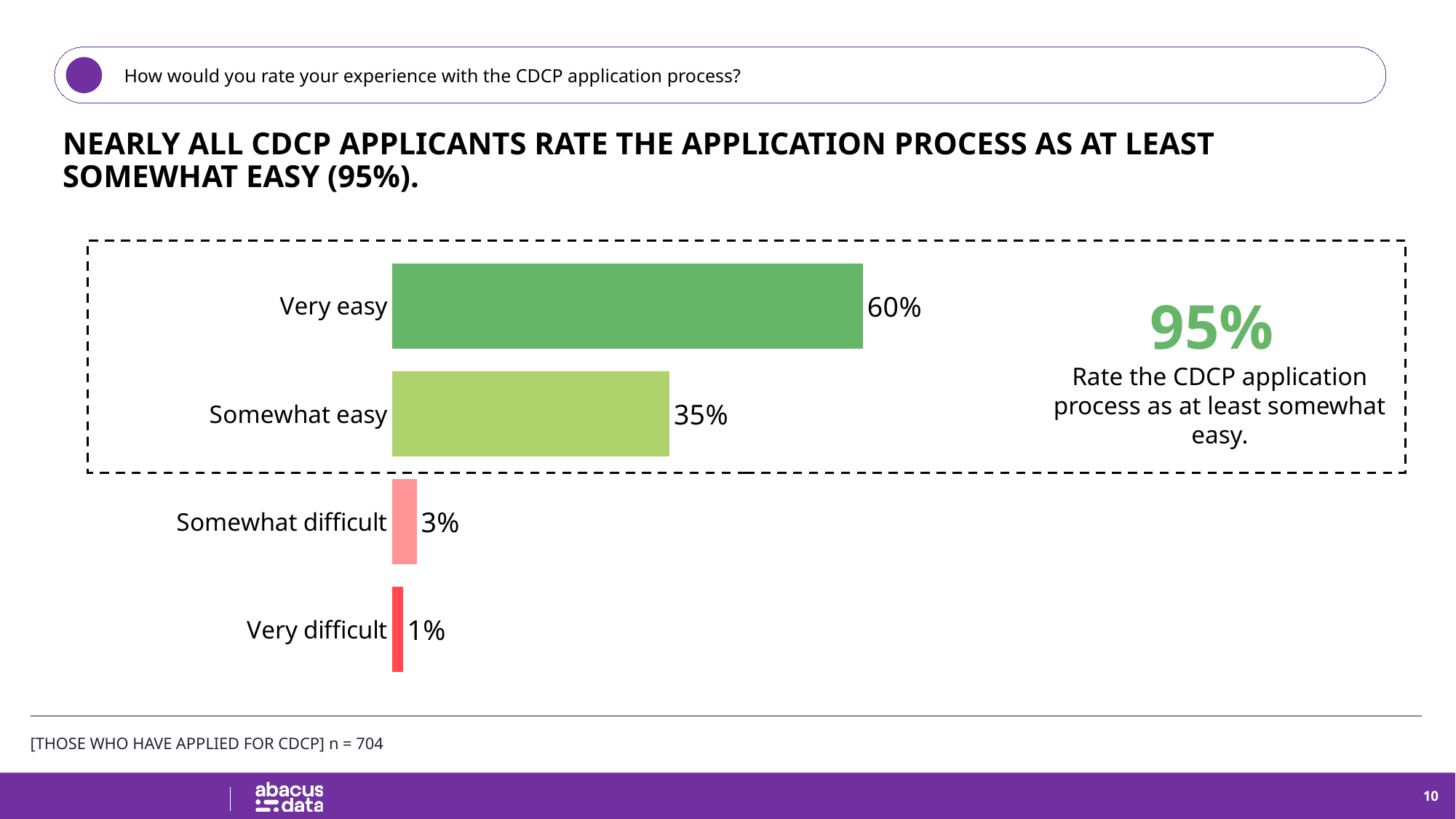
What percentage of CDCP applicants rated the application process as Very difficult? 1% Which rating category has the lowest value? Very difficult Which rating category has the highest value? Very easy What sample size is given for those who have applied for CDCP? n = 704 What percentage of CDCP applicants rated the application process as Somewhat easy? 35% What is the difference between the Very easy and Somewhat easy percentages? 25 percentage points What percentage of CDCP applicants rated the application process as Somewhat difficult? 3% What kind of chart is shown on the slide? Bar chart What percentage of CDCP applicants rated the application process as Very easy? 60% How many rating categories are shown in the chart? 4 Which is larger, the value for Somewhat difficult or the value for Very difficult? Somewhat difficult What is the combined percentage of Very easy and Somewhat easy ratings? 95%